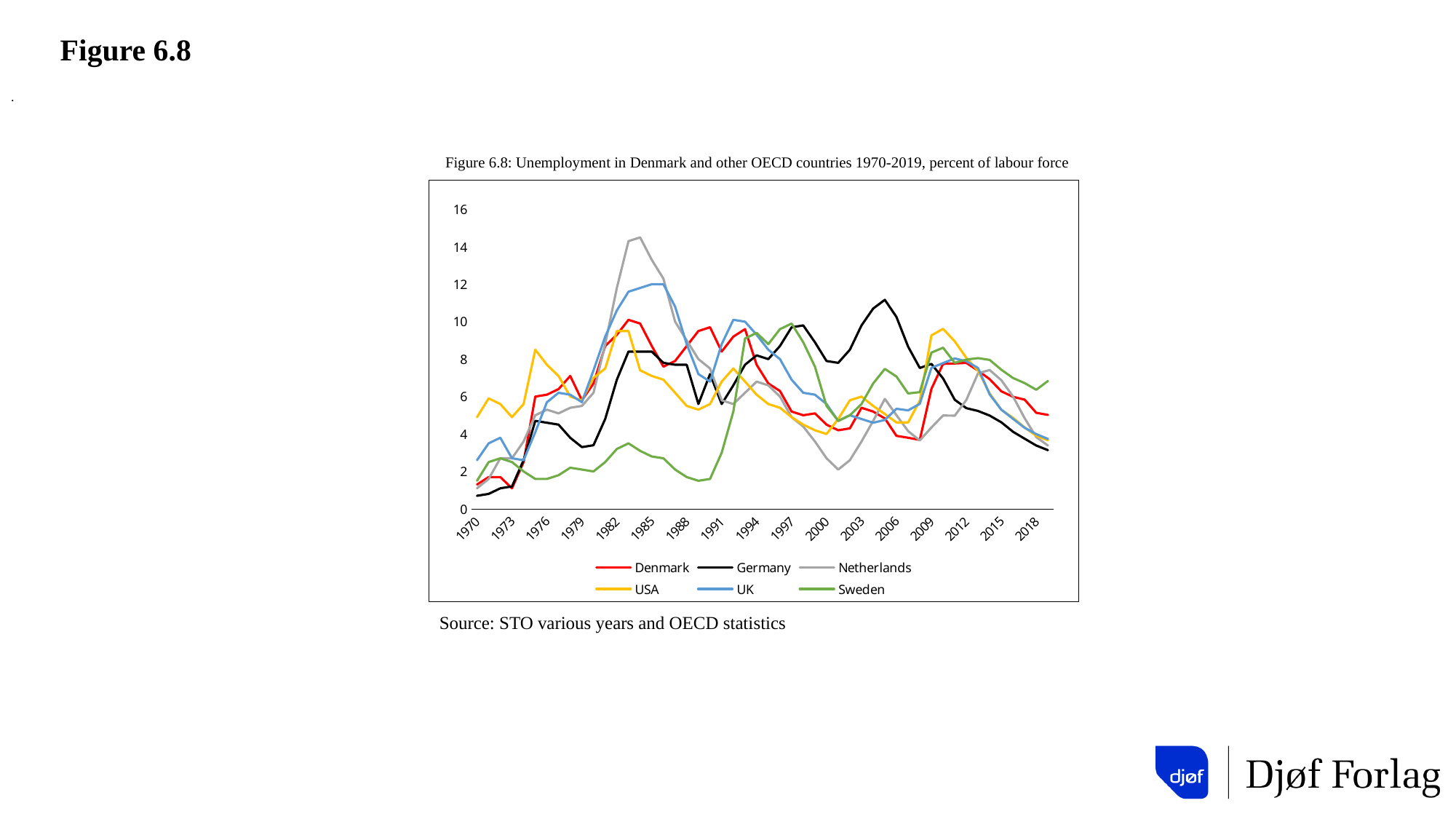
How many series does the legend list? 6 What kind of chart is shown on the slide? Line chart Does the value for Germany rise or fall from 2005 to 2019? fall Is the value for Denmark in 1970 greater or less than 2? less Is the value for Sweden in 1988 greater or less than 4? less In 1985, which is higher, the value for UK or the value for Sweden? UK In 2005, which is higher, the value for Germany or the value for Denmark? Germany Is the value for Netherlands in 1983 greater or less than 12? greater What colour is the line for Denmark? Red Which country's line reaches the highest value anywhere on the chart? Netherlands What is the title of the chart? Figure 6.8: Unemployment in Denmark and other OECD countries 1970-2019, percent of labour force